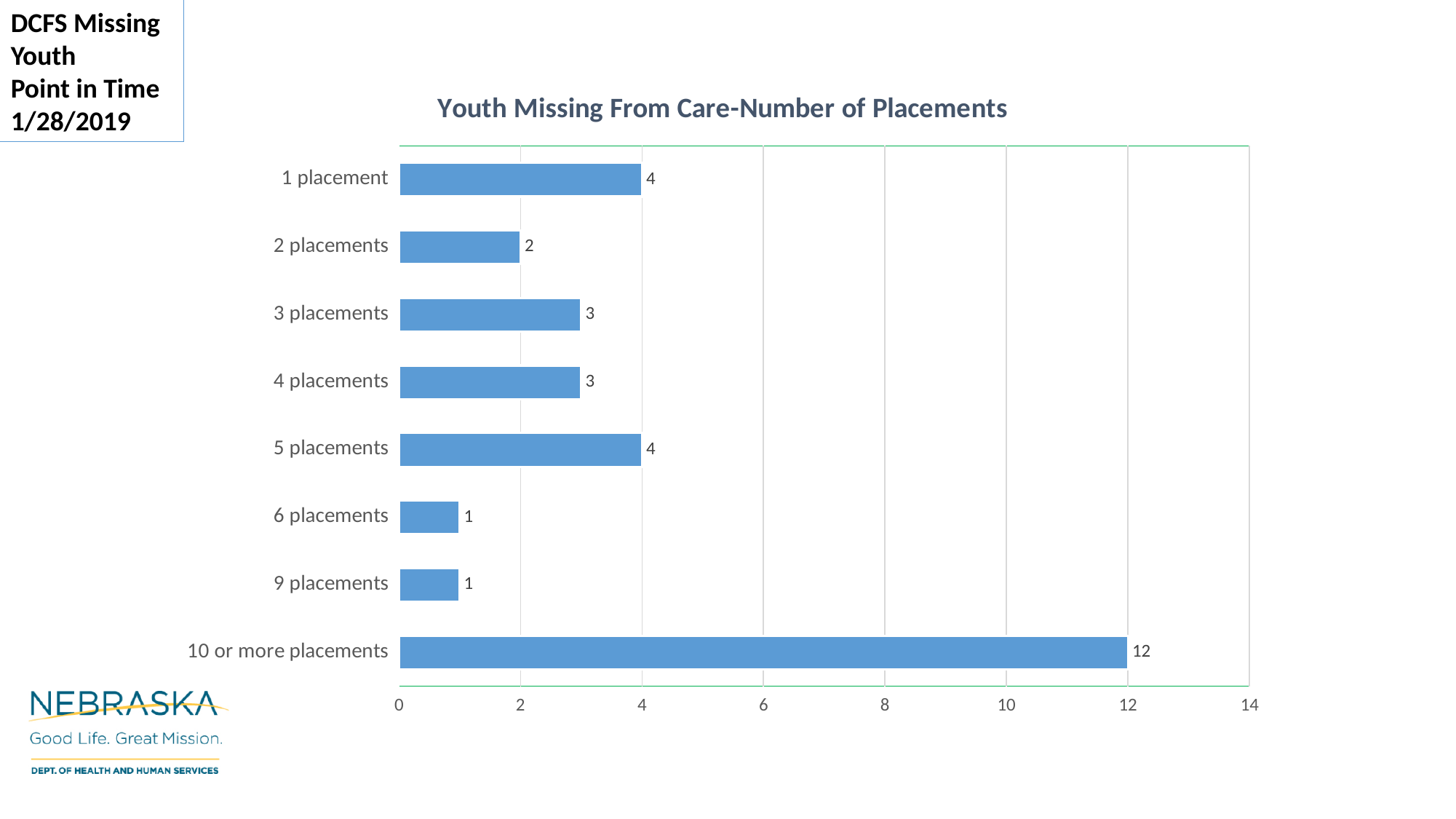
How many categories are shown in the chart? 8 What is the value for 2 placements? 2 What is the title of the chart? Youth Missing From Care-Number of Placements Is the value for 10 or more placements greater or less than 10? greater What is the difference between the values for 1 placement and 2 placements? 2 What kind of chart is shown on the slide? bar chart What is the value for 9 placements? 1 Which category has the highest value? 10 or more placements What is the value for 5 placements? 4 What is the value for 10 or more placements? 12 What is the difference between the values for 10 or more placements and 1 placement? 8 Which is larger, the value for 3 placements or the value for 6 placements? 3 placements